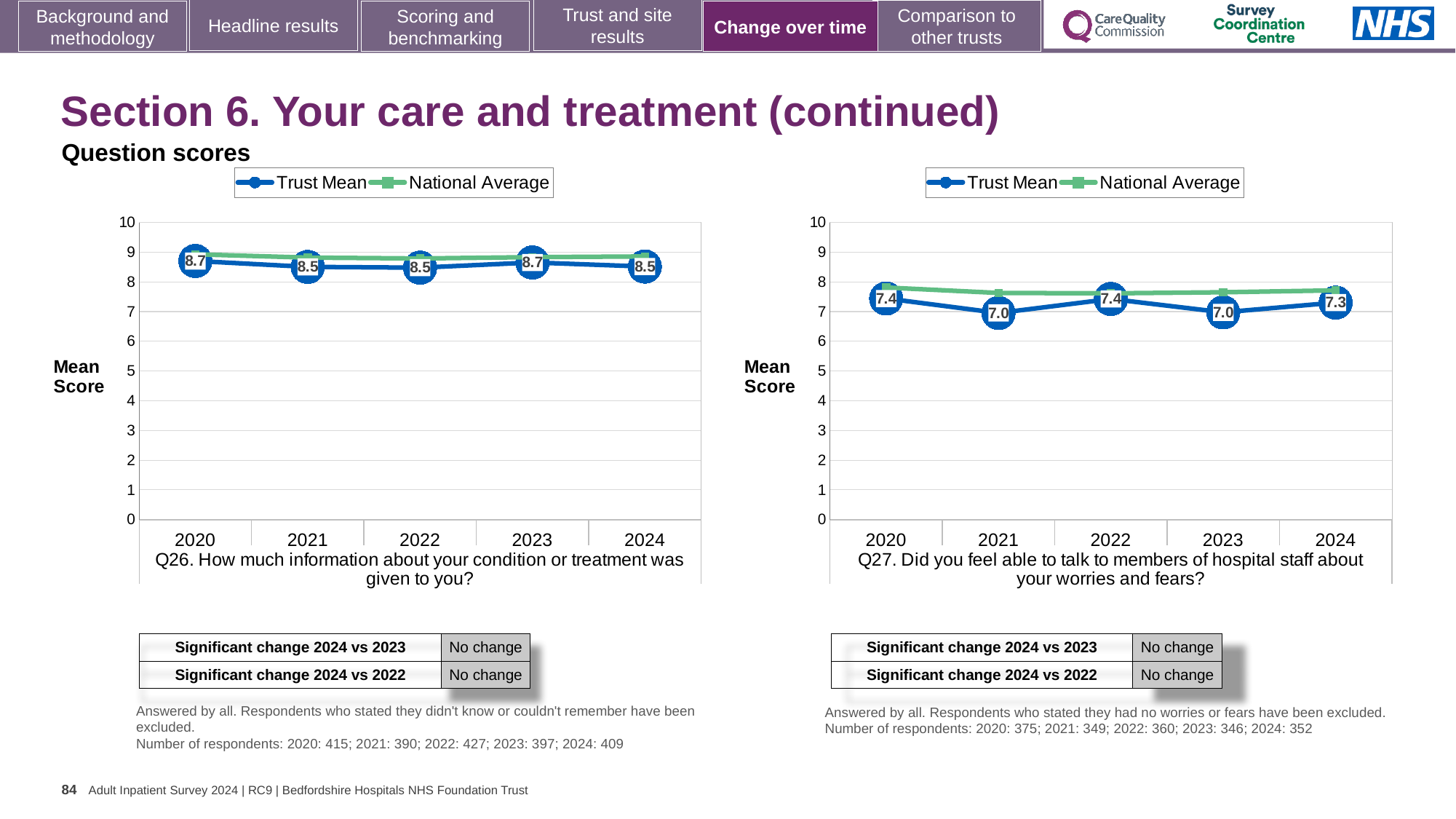
In the Q26 chart (left), is the National Average for 2024 greater or less than 8? greater In the Q26 chart (left), is the Trust Mean score for 2023 higher or lower than for 2024? higher What type of chart is used for Q26 (left)? Line chart In the Q27 chart (right), what is the Trust Mean score for 2021? 7.0 In the Q26 chart (left), what is the Trust Mean score for 2024? 8.5 In the Q27 chart (right), is the Trust Mean score for 2020 greater or less than 7? greater In the Q27 chart (right), what is the difference between the Trust Mean scores for 2022 and 2023? 0.4 In the Q27 chart (right), what is the Trust Mean score for 2024? 7.3 How many series does the legend of the Q26 chart (left) list? 2 In the Q26 chart (left), what is the Trust Mean score for 2020? 8.7 In the Q27 chart (right), which series is shown in green? National Average How many years are plotted on the x axis of the Q27 chart (right)? 5